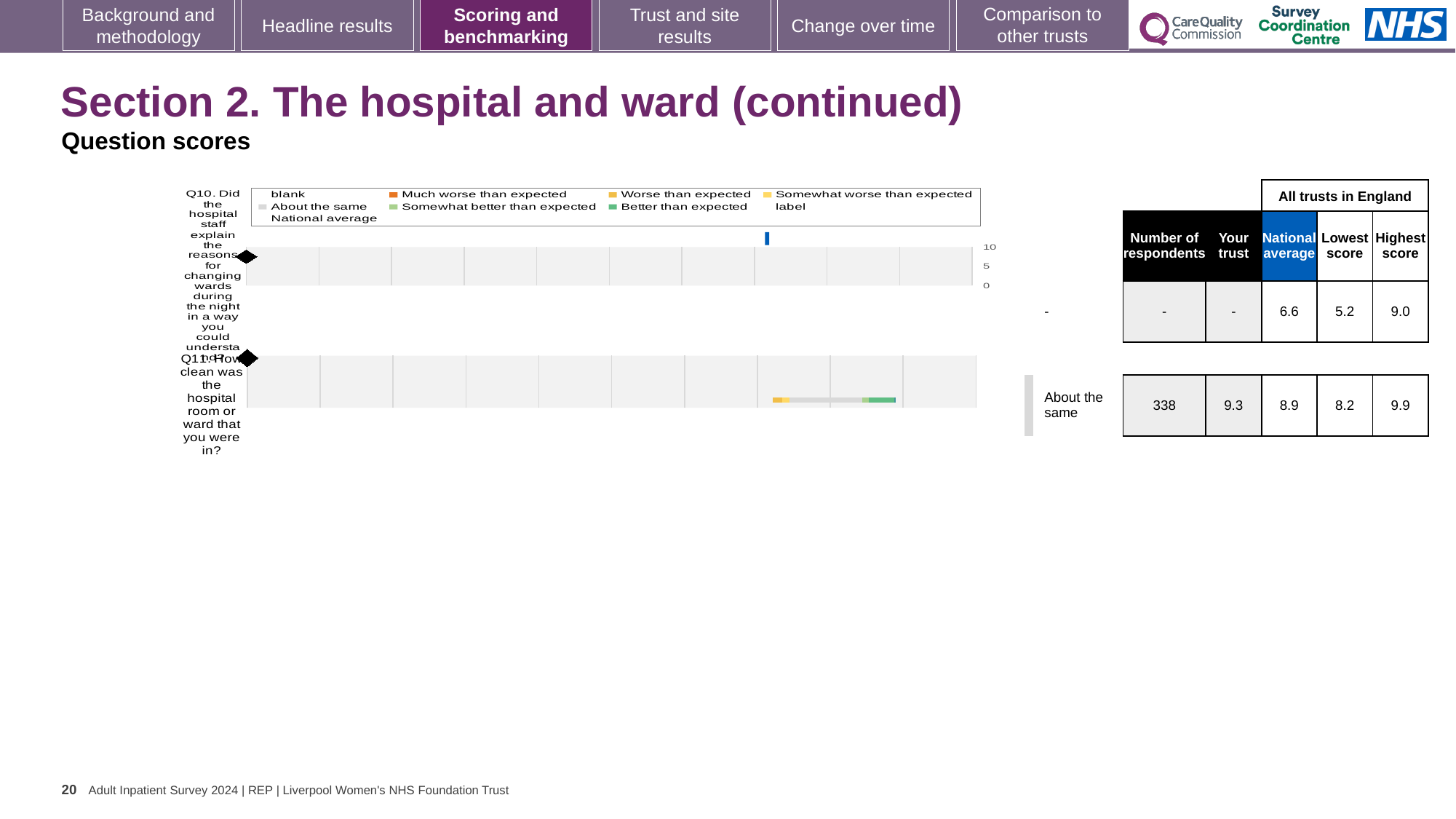
What is the national average score for Q10? 6.6 What benchmark category is given for Q11? About the same What is the highest score among all trusts in England for Q11? 9.9 For Q11, is the trust's score higher or lower than the national average? higher For Q11, how much higher is the trust's score than the national average? 0.4 What is the 'Your trust' score for Q11 (How clean was the hospital room or ward that you were in?)? 9.3 What is the number of respondents for Q11? 338 How many questions (categories) are plotted on the chart? 2 What is the lowest score among all trusts in England for Q10? 5.2 What is the national average score for Q11? 8.9 What kind of chart is shown on the slide? bar chart What is the maximum value shown on the chart's horizontal axis? 10